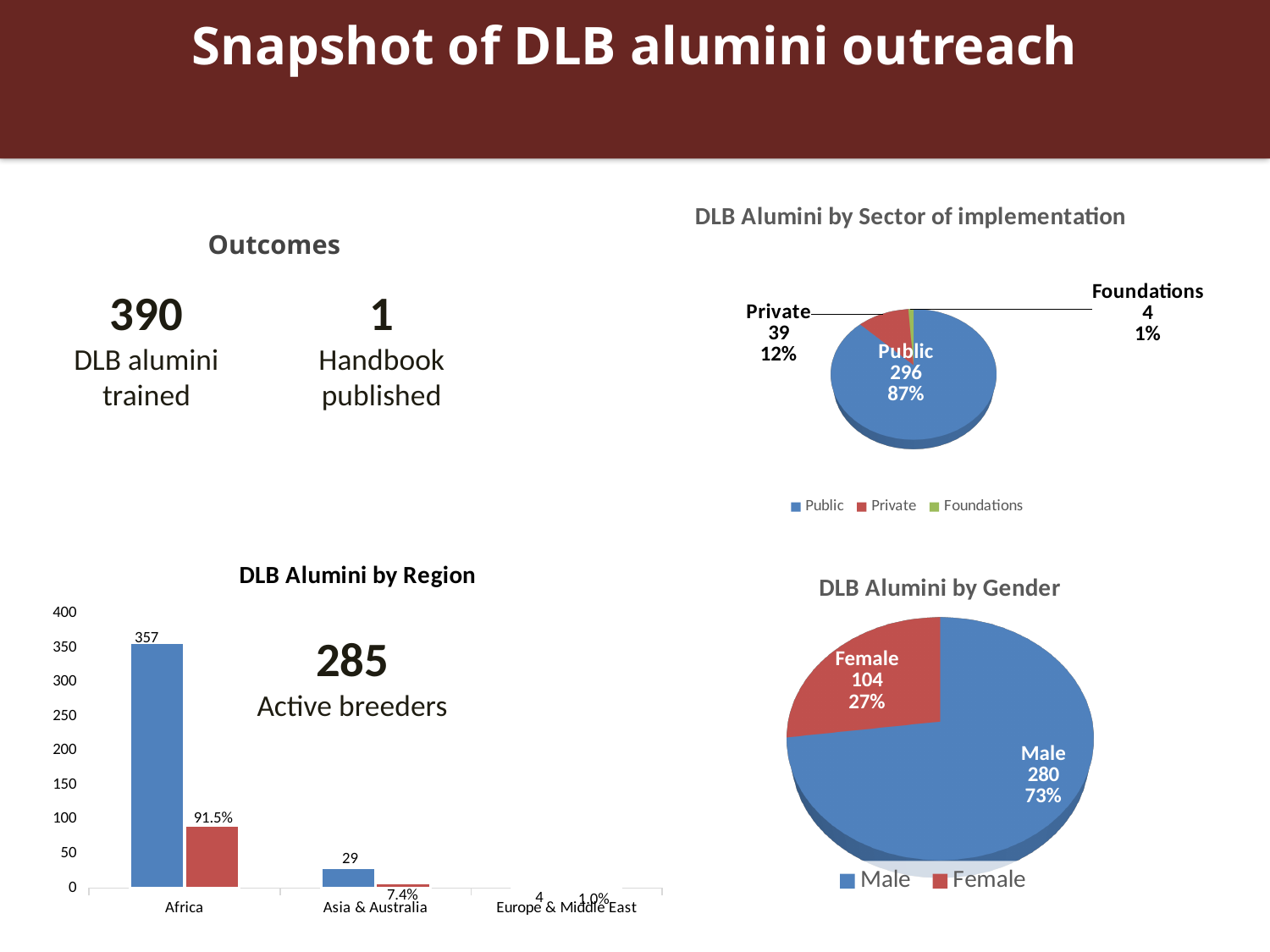
In the 'DLB Alumini by Region' chart, what is the number of alumni for Asia & Australia? 29 In the 'DLB Alumini by Sector of implementation' pie chart, which sector has the smallest slice? Foundations In the 'DLB Alumini by Region' chart, what is the number of alumni for Africa? 357 In the 'DLB Alumini by Gender' pie chart, what share of alumni is Female? 27% In the 'DLB Alumini by Region' chart, what is the difference between the number of alumni for Africa and for Asia & Australia? 328 In the 'DLB Alumini by Sector of implementation' pie chart, how many sectors are shown? 3 In the 'DLB Alumini by Sector of implementation' pie chart, how many alumni are in the Public sector? 296 In the 'DLB Alumini by Gender' pie chart, how many alumni are Male? 280 In the 'DLB Alumini by Sector of implementation' pie chart, what share of alumni is in the Private sector? 12% What type of chart is 'DLB Alumini by Region'? Bar chart In the 'DLB Alumini by Region' chart, which region has the highest number of alumni? Africa In the 'DLB Alumini by Gender' pie chart, what is the difference between the number of Male and Female alumni? 176